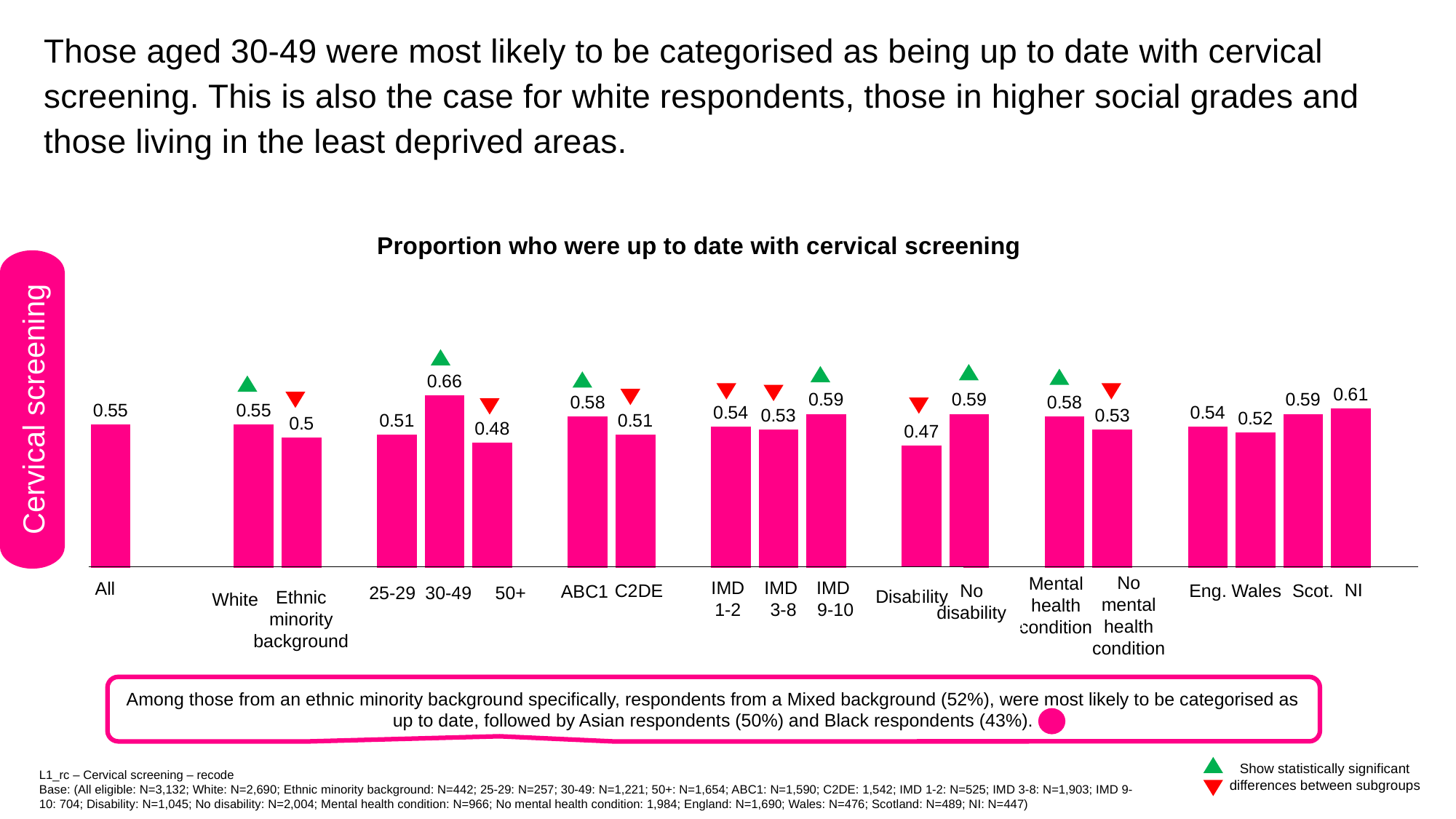
Which has the larger value, Wales or Scot.? Scot. How many bars are plotted in the chart? 19 Which category has the lowest value? Disability What is the value for the Ethnic minority background group? 0.5 What is the difference between the values for ABC1 and C2DE? 0.07 What is the value for the 30-49 age group? 0.66 Which category has the highest value? 30-49 Which has the larger value, IMD 1-2 or IMD 9-10? IMD 9-10 What is the value for NI? 0.61 What is the title of the chart? Proportion who were up to date with cervical screening What is the value for respondents with a disability? 0.47 What is the difference between the values for 30-49 and 50+? 0.18